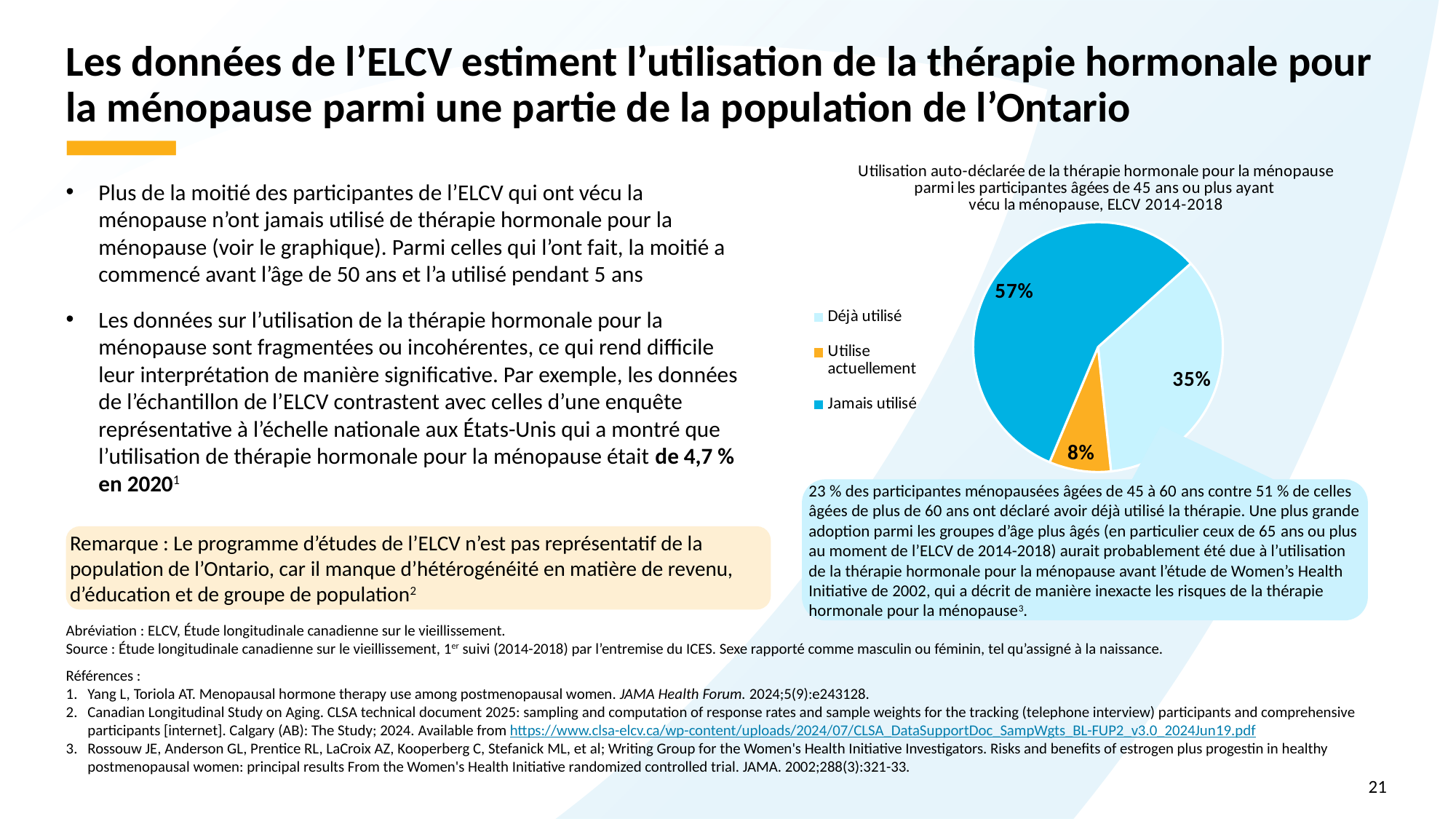
Which colour represents "Utilise actuellement" in the pie chart? Orange How many categories does the pie chart show? 3 What is the combined share of "Déjà utilisé" and "Utilise actuellement"? 43% What kind of chart is shown on the slide? Pie chart Which category has the largest slice of the pie? Jamais utilisé What share of the pie is labelled "Déjà utilisé"? 35% What share of the pie is labelled "Utilise actuellement"? 8% Which is larger: the slice for "Déjà utilisé" or the slice for "Utilise actuellement"? Déjà utilisé What period does the chart title say the ELCV data cover? 2014-2018 Which category has the smallest slice of the pie? Utilise actuellement What is the difference in percentage points between "Jamais utilisé" and "Déjà utilisé"? 22 What share of the pie is labelled "Jamais utilisé"? 57%